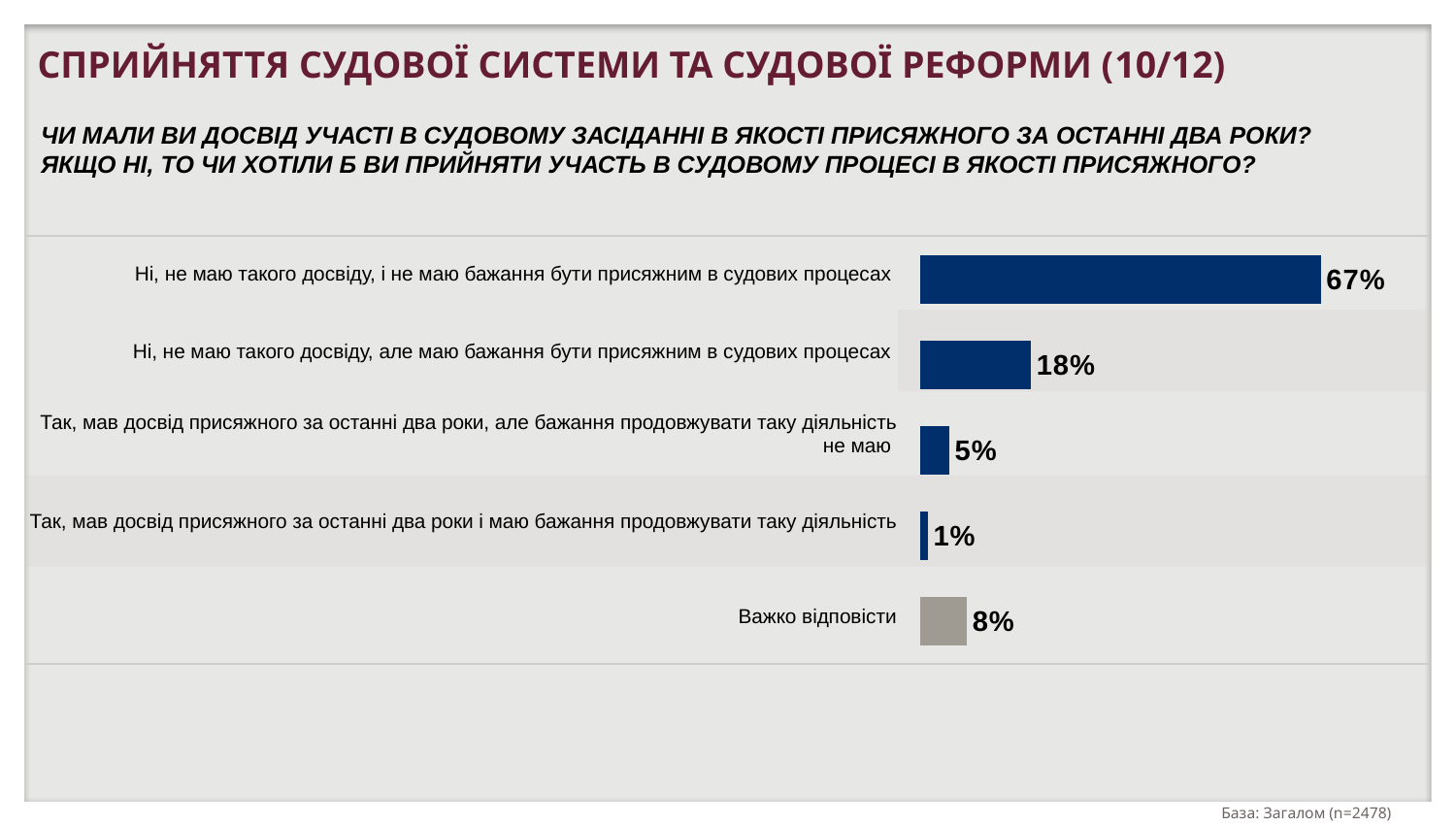
What percentage of respondents said they had jury experience in the last two years and want to continue ("Так, мав досвід присяжного за останні два роки і маю бажання продовжувати таку діяльність")? 1% Which is larger: the value for "Важко відповісти" or the value for "Так, мав досвід присяжного за останні два роки, але бажання продовжувати таку діяльність не маю"? Важко відповісти Which category has the lowest value? Так, мав досвід присяжного за останні два роки і маю бажання продовжувати таку діяльність What is the value for "Важко відповісти"? 8% What kind of chart is shown on the slide? Bar chart What is the sample size (base) stated on the slide? n=2478 What is the value for "Ні, не маю такого досвіду, але маю бажання бути присяжним в судових процесах"? 18% Which category has the highest value? Ні, не маю такого досвіду, і не маю бажання бути присяжним в судових процесах What is the difference between the values for "Ні, не маю такого досвіду, і не маю бажання бути присяжним в судових процесах" and "Ні, не маю такого досвіду, але маю бажання бути присяжним в судових процесах"? 49% What is the difference between the values for "Так, мав досвід присяжного за останні два роки, але бажання продовжувати таку діяльність не маю" and "Так, мав досвід присяжного за останні два роки і маю бажання продовжувати таку діяльність"? 4% What percentage of respondents answered "Ні, не маю такого досвіду, і не маю бажання бути присяжним в судових процесах"? 67% How many categories are shown in the chart? 5